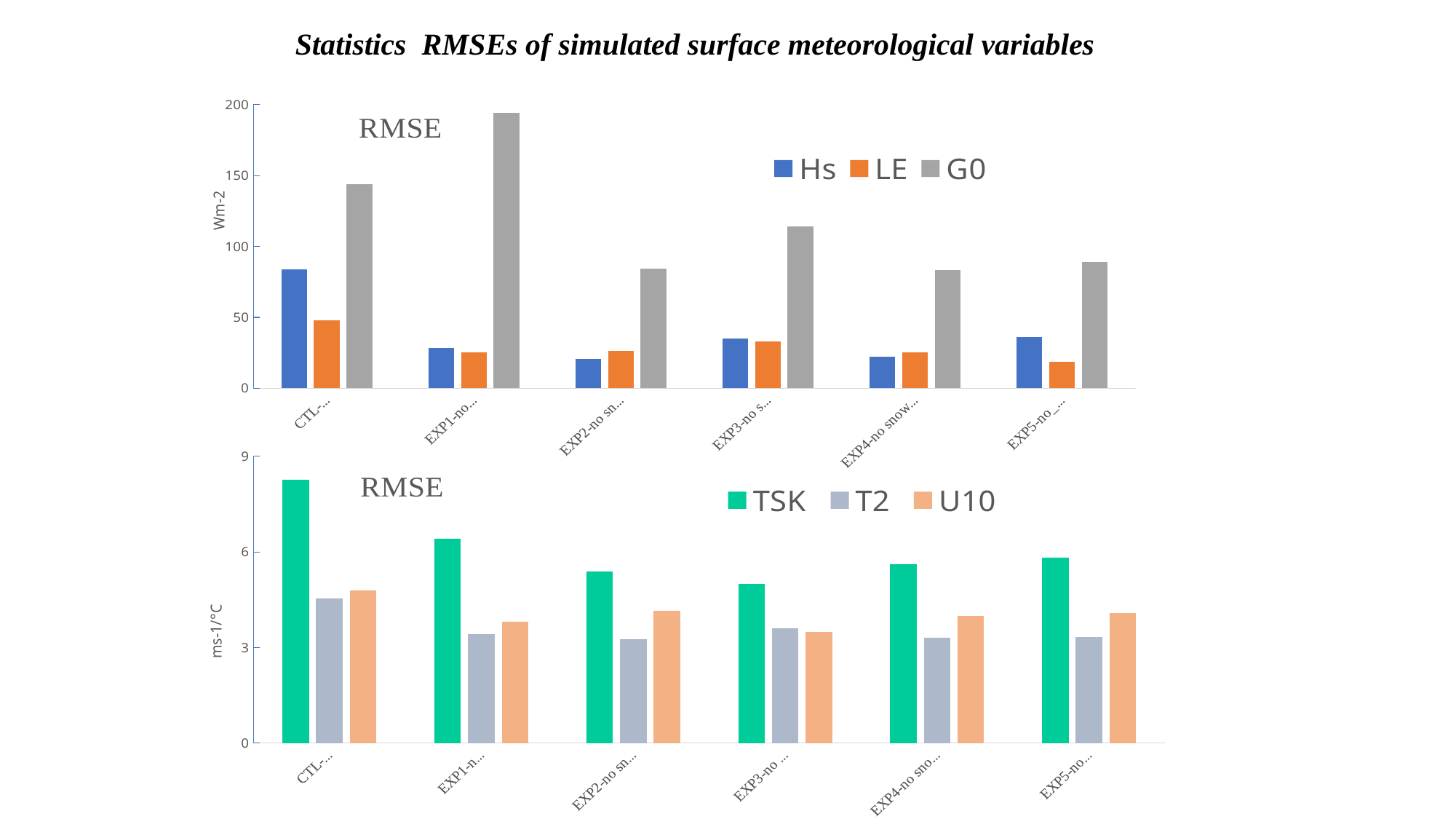
In the top chart, is the G0 value for CTL greater or less than 100? greater How many series does the legend of the top chart list? 3 How many categories are shown on the x axis of the bottom chart? 6 What is the y-axis label of the top chart? Wm-2 In the bottom chart, is the TSK value for CTL greater or less than 6? greater What type of chart is the top chart on the slide? bar chart In the top chart, which is larger for CTL, Hs or LE? Hs In the bottom chart, which category has the highest TSK value? CTL How many series does the legend of the bottom chart list? 3 In the top chart, which series has the tallest bar in every category? G0 In the top chart, is the Hs value for EXP2 greater or less than 50? less In the top chart, which category has the highest G0 value? EXP1